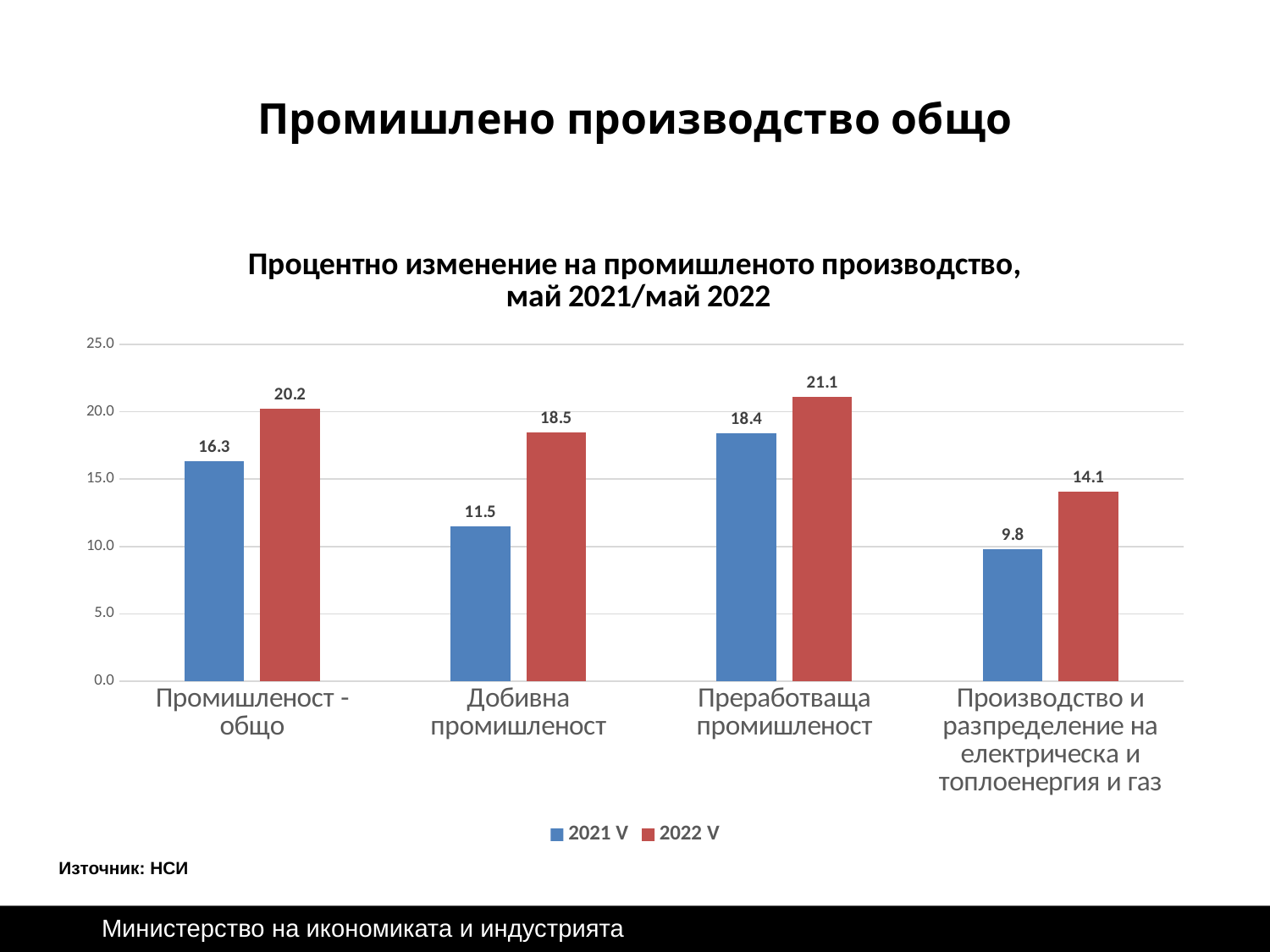
Which category has the lowest value for 2021 V? Производство и разпределение на електрическа и топлоенергия и газ What is the value for 2021 V for Производство и разпределение на електрическа и топлоенергия и газ? 9.8 What is the difference between the 2022 V and 2021 V values for Промишленост - общо? 3.9 How many series does the legend list? 2 Which category has the highest value for 2022 V? Преработваща промишленост What is the title of the chart? Процентно изменение на промишленото производство, май 2021/май 2022 How many categories are shown on the x axis? 4 Which is larger for Преработваща промишленост: the 2021 V value or the 2022 V value? 2022 V What is the value for 2021 V for Промишленост - общо? 16.3 What is the difference between the 2022 V and 2021 V values for Добивна промишленост? 7.0 What kind of chart is shown on the slide? Bar chart What is the value for 2022 V for Добивна промишленост? 18.5